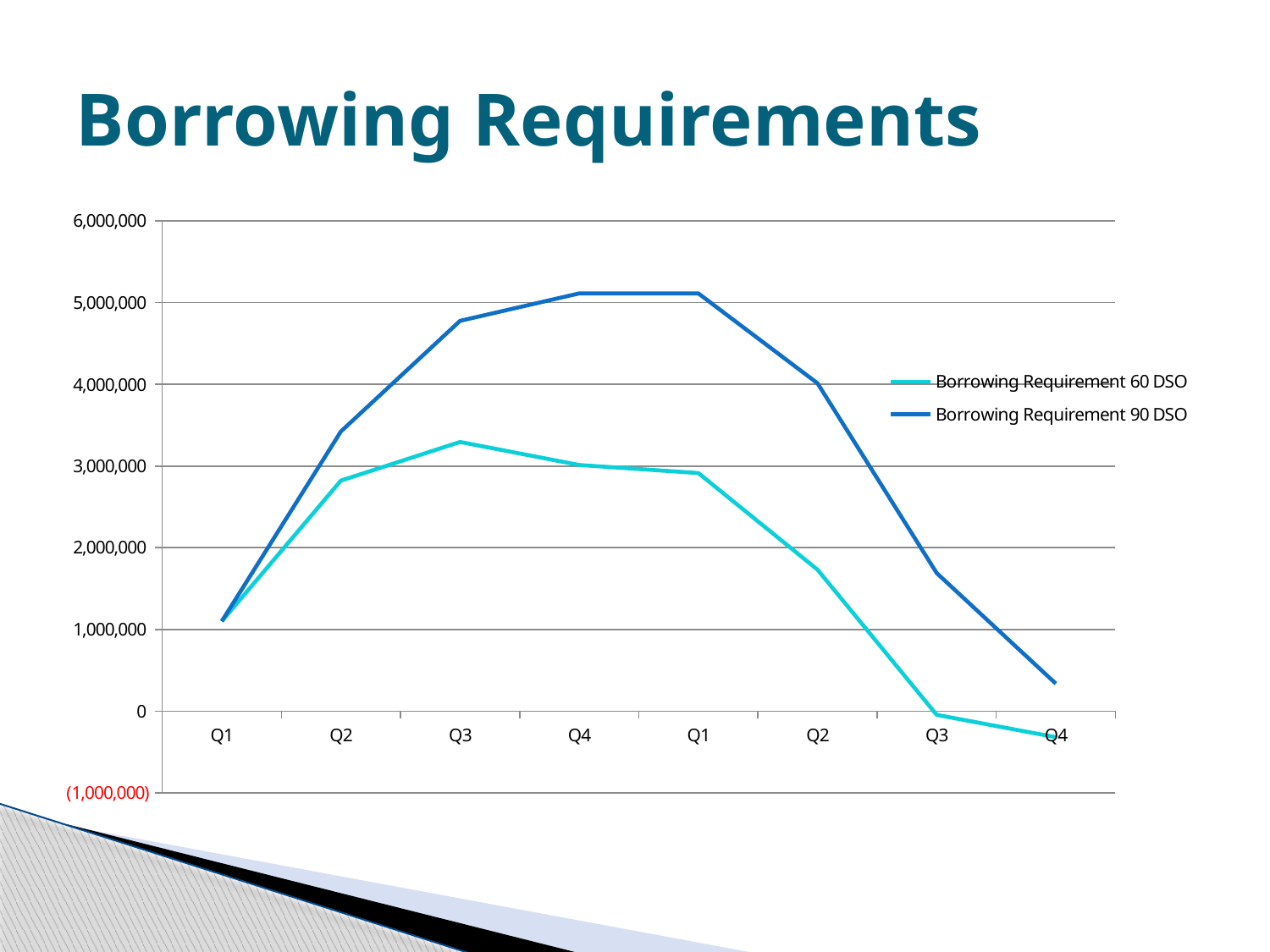
How many series does the legend list? 2 At which quarter does the Borrowing Requirement 60 DSO line reach its highest value? the first Q3 Is the Borrowing Requirement 90 DSO value at the first Q3 greater or less than 4,000,000? greater Is the Borrowing Requirement 60 DSO value at the last Q4 greater or less than 0? less Is the Borrowing Requirement 60 DSO value at the first Q3 greater or less than 3,000,000? greater At the first Q3, which series has the larger value, Borrowing Requirement 60 DSO or Borrowing Requirement 90 DSO? Borrowing Requirement 90 DSO What kind of chart is shown on the slide? line chart Does the Borrowing Requirement 90 DSO line rise or fall from the first Q1 to the first Q4? rise At which quarter does the Borrowing Requirement 90 DSO line reach its lowest value? the last Q4 How many quarters are plotted along the x axis? 8 What is the title of the slide containing the chart? Borrowing Requirements